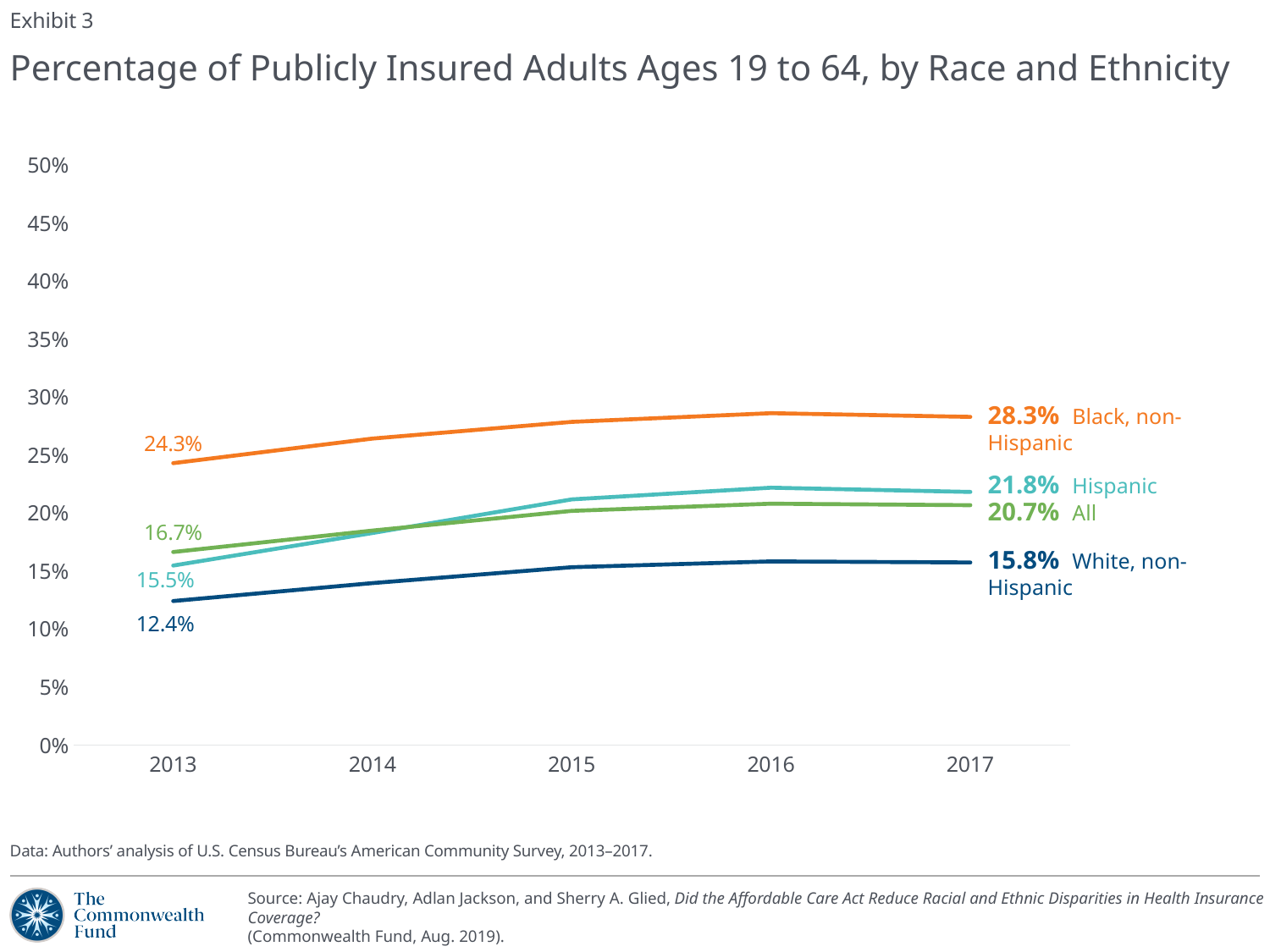
What kind of chart is this? Line chart Which group had the lowest percentage of publicly insured adults in 2013? White, non-Hispanic In 2013, which was larger: the Hispanic value or the All value? All What was the percentage of publicly insured White, non-Hispanic adults in 2013? 12.4% What was the percentage of publicly insured Black, non-Hispanic adults in 2013? 24.3% What was the percentage of publicly insured Hispanic adults in 2017? 21.8% What was the value for All adults in 2017? 20.7% How many years are shown on the x axis? 5 By how many percentage points did the Black, non-Hispanic value change from 2013 to 2017? 4.0 percentage points Which group had the highest percentage of publicly insured adults in 2017? Black, non-Hispanic Is the value for Black, non-Hispanic adults in 2016 greater or less than 25%? greater What is the difference between the Hispanic and White, non-Hispanic values in 2017? 6.0 percentage points